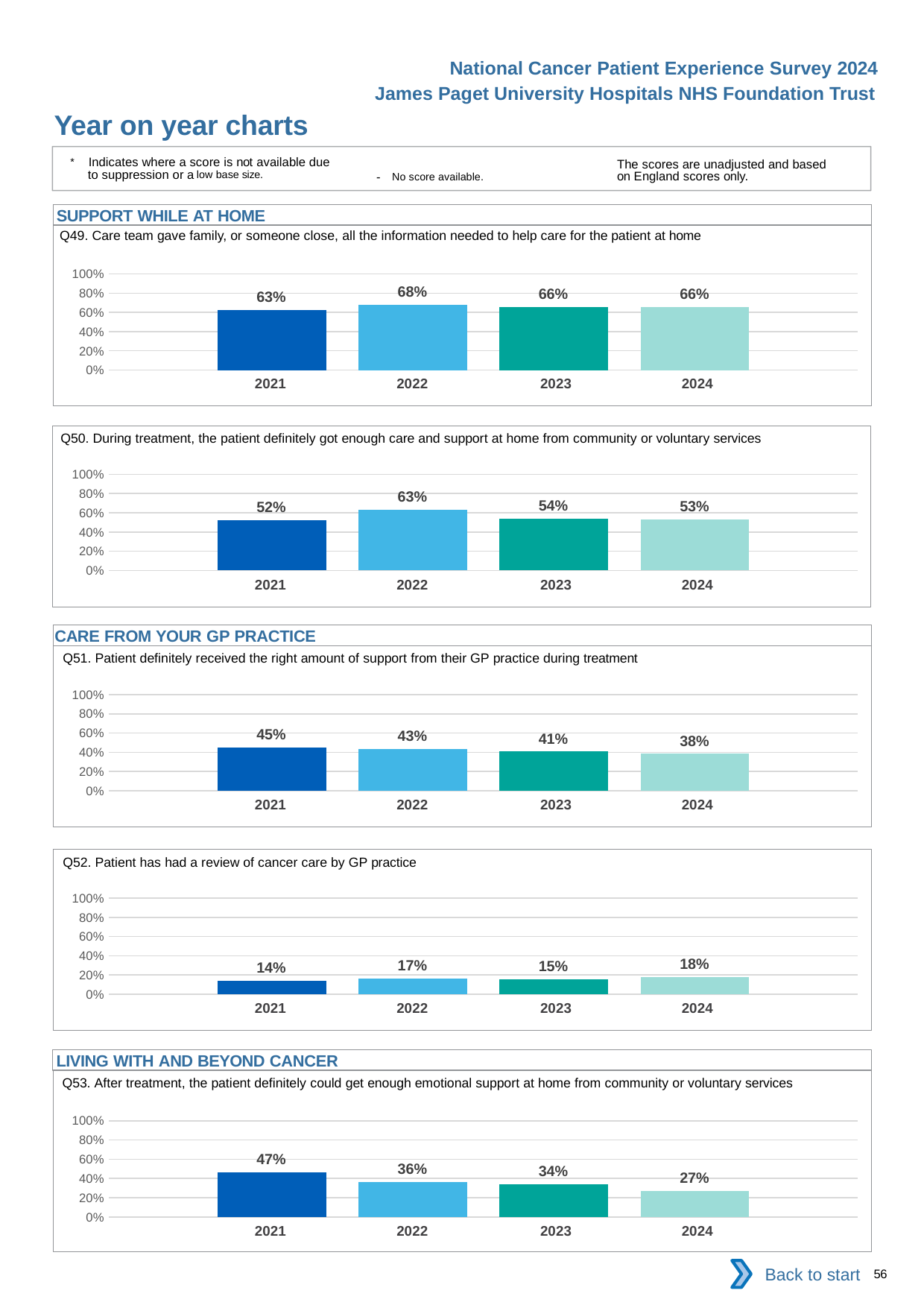
How many years are shown in the Q53 chart? 4 In the Q53 chart, which is larger, the value for 2021 or the value for 2024? 2021 In the Q50 chart, what is the difference between the 2022 and 2021 values? 11% In the Q49 chart, which year has the lowest value? 2021 In the Q51 chart, what is the value for 2024? 38% In the Q52 chart, which year has the highest value? 2024 In the Q49 chart, what is the value for 2022? 68% What type of chart is used for Q49? bar chart In the Q50 chart, which year has the highest value? 2022 In the Q53 chart, what is the difference between the 2021 and 2024 values? 20% In the Q51 chart, do the values rise or fall from 2021 to 2024? fall In the Q52 chart, is the value for 2021 greater or less than 20%? less